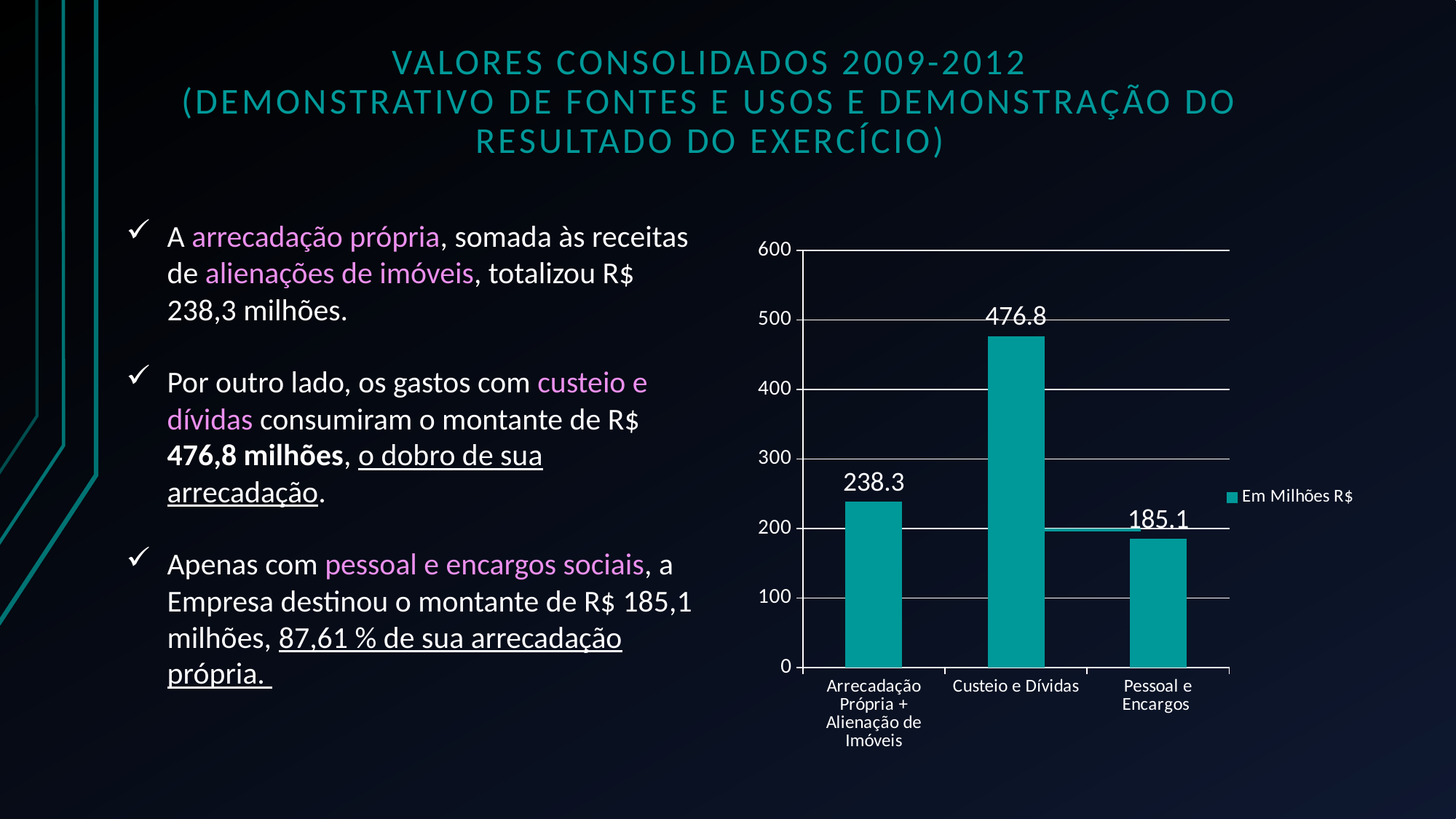
What is the difference between the values for Custeio e Dívidas and Arrecadação Própria + Alienação de Imóveis? 238.5 Is the value for Pessoal e Encargos greater or less than 200? less Which category has the highest value? Custeio e Dívidas What is the value for Pessoal e Encargos? 185.1 Which is larger, the value for Custeio e Dívidas or the value for Pessoal e Encargos? Custeio e Dívidas How many categories are shown on the x axis? 3 What is the difference between the values for Arrecadação Própria + Alienação de Imóveis and Pessoal e Encargos? 53.2 How many series does the legend list? 1 What is the value for Custeio e Dívidas? 476.8 What kind of chart is shown on the slide? bar chart What is the value for Arrecadação Própria + Alienação de Imóveis? 238.3 Which category has the lowest value? Pessoal e Encargos